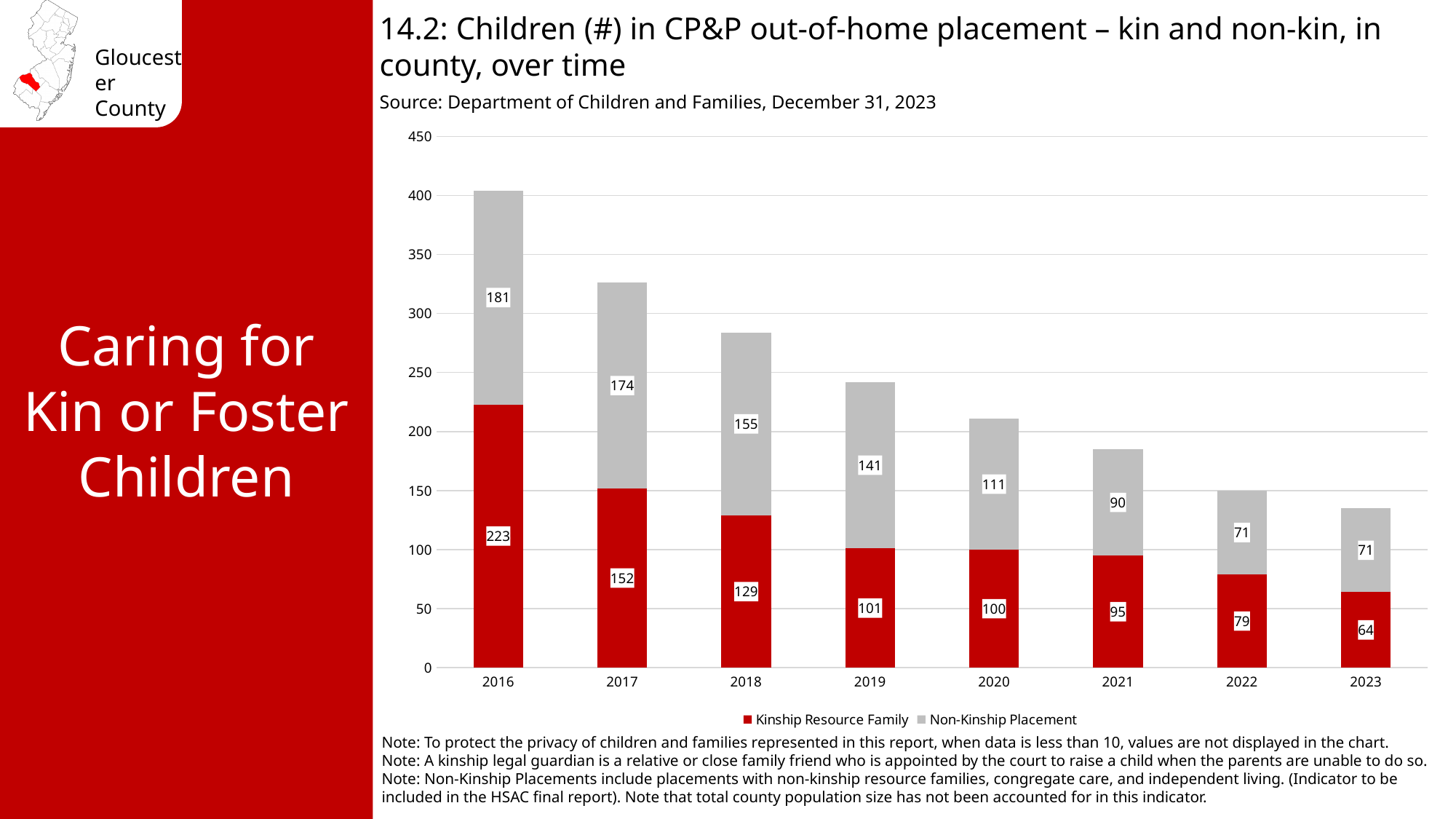
What is the total of the stacked bar for 2016? 404 What is the Non-Kinship Placement value for 2019? 141 How many years are shown on the x axis? 8 How many series does the legend list? 2 Which year has the lowest Non-Kinship Placement value? 2022 and 2023 (both 71) What is the difference between the Non-Kinship Placement values for 2016 and 2017? 7 Which year has the highest Kinship Resource Family value? 2016 What is the Kinship Resource Family value for 2023? 64 What is the total of the stacked bar for 2020? 211 Which is larger, the Kinship Resource Family value for 2018 or the Non-Kinship Placement value for 2018? Non-Kinship Placement (155) What kind of chart is shown? Stacked bar chart What is the Kinship Resource Family value for 2016? 223